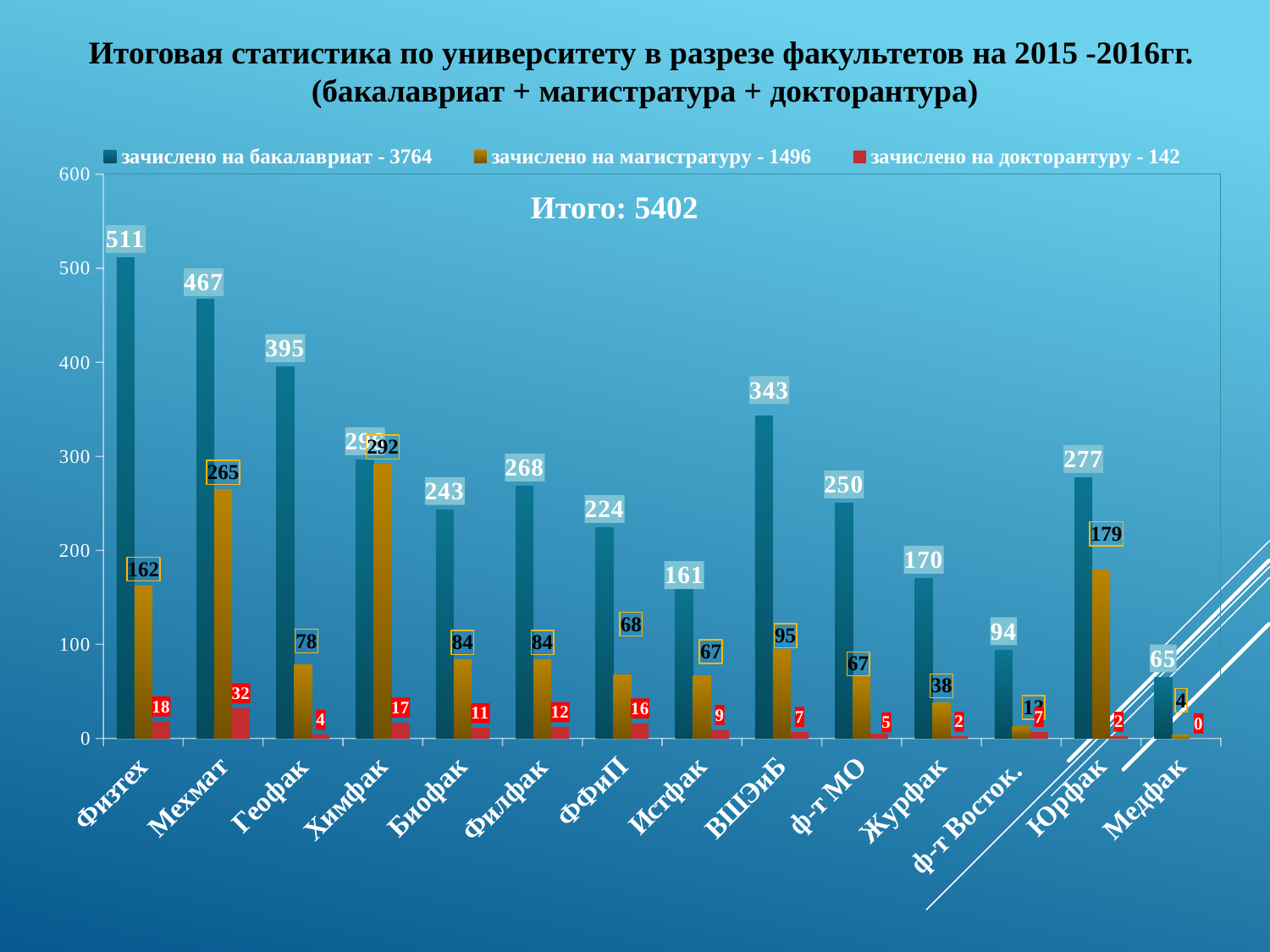
What type of chart is shown on the slide? bar chart What is the value for зачислено на бакалавриат for Физтех? 511 What is the difference between the бакалавриат values for Физтех and Мехмат? 44 What is the value for зачислено на магистратуру for Юрфак? 179 Which faculty has the lowest value for зачислено на бакалавриат? Медфак Which faculty has the highest value for зачислено на бакалавриат? Физтех How many faculties (categories) are shown on the x axis? 14 Which is larger: the бакалавриат value for ВШЭиБ or for Геофак? Геофак What is the value for зачислено на докторантуру for Мехмат? 32 Which faculty has the highest value for зачислено на магистратуру? Химфак How many series does the legend list? 3 What total is shown on the chart (Итого)? 5402